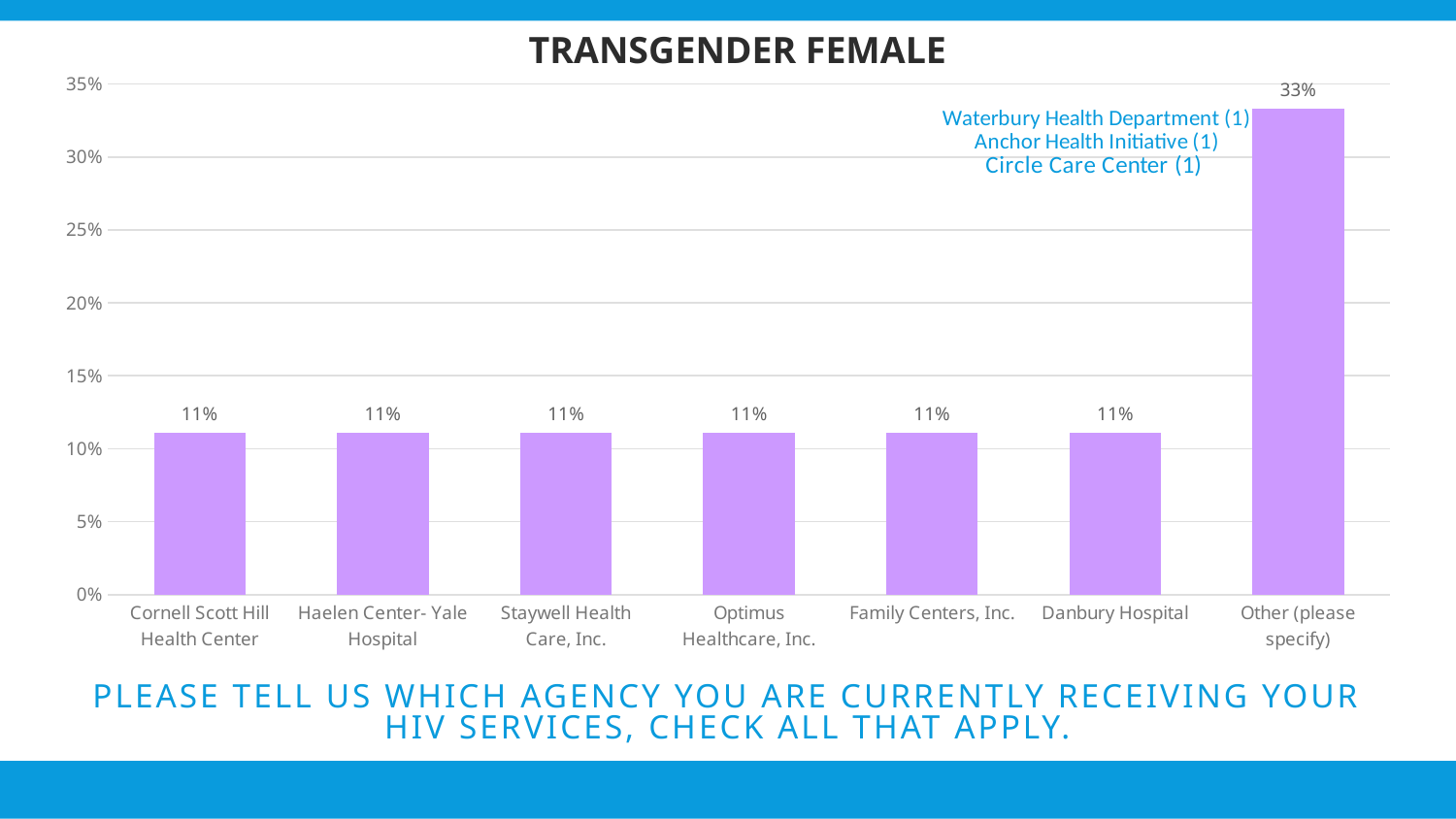
Is the value for Other (please specify) greater or less than 30%? greater How many categories have a value of 11%? 6 Which is larger, the value for Other (please specify) or the value for Staywell Health Care, Inc.? Other (please specify) What is the value for Danbury Hospital? 11% Which category has the highest value? Other (please specify) How many categories are shown on the x axis? 7 Is the value for Optimus Healthcare, Inc. greater or less than 15%? less What is the title of the chart? TRANSGENDER FEMALE What is the difference between the value for Other (please specify) and the value for Family Centers, Inc.? 22% What kind of chart is shown on the slide? Bar chart What is the value for Cornell Scott Hill Health Center? 11% What is the value for Other (please specify)? 33%